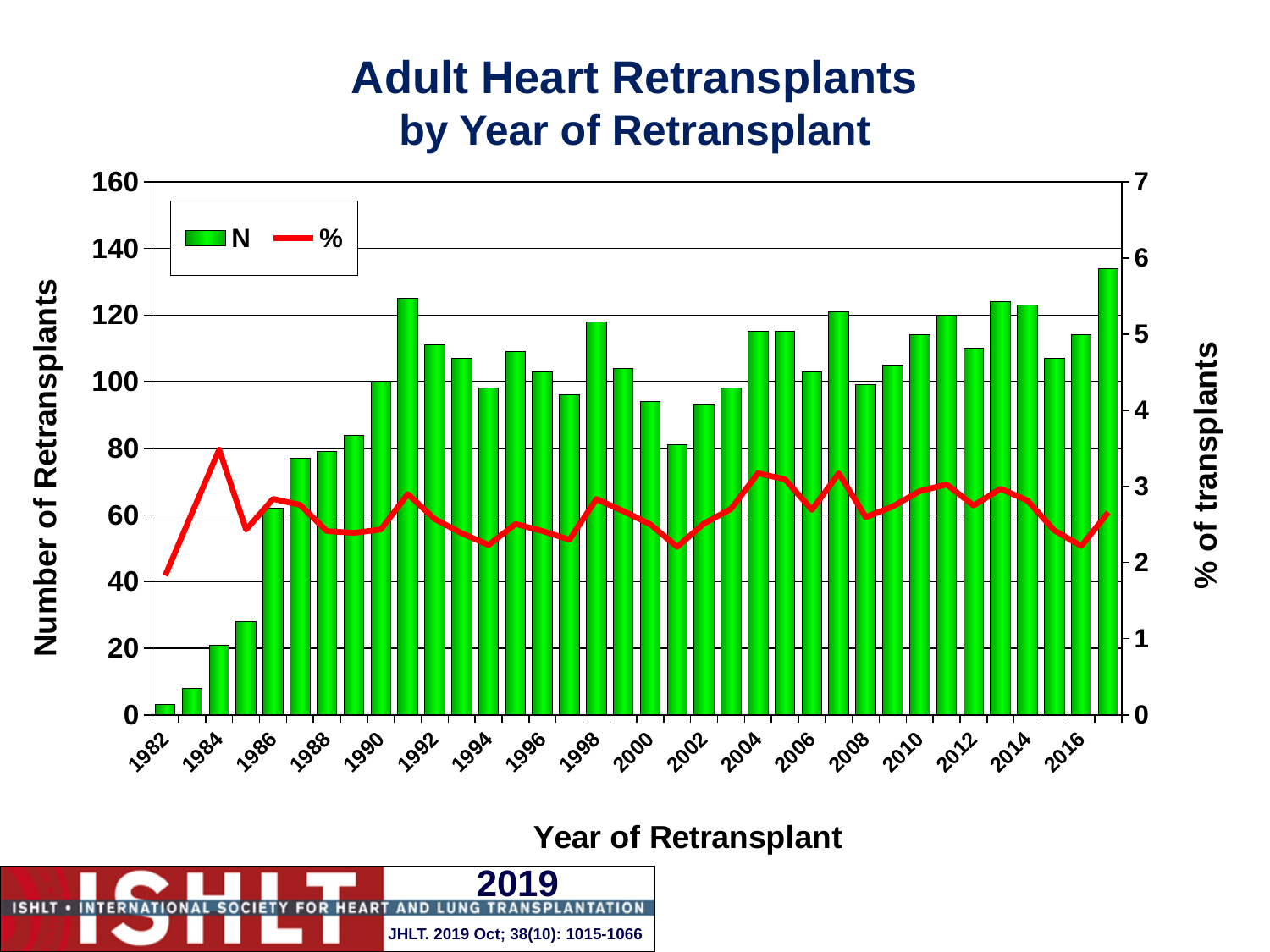
What kind of chart is shown on the slide? bar chart with a line Which year has more retransplants, 2004 or 2006? 2004 How many series does the legend list? 2 Is the number of retransplants in 2012 greater or less than 100? greater What is the title of the right-hand vertical axis? % of transplants Which year has more retransplants, 1992 or 2002? 1992 Which year has the lowest number of retransplants? 1982 Is the number of retransplants in 2002 greater or less than 100? less Is the number of retransplants in 1992 greater or less than 100? greater In which year does the % of transplants line reach its highest point? 1984 What are the two entries in the legend? N and %